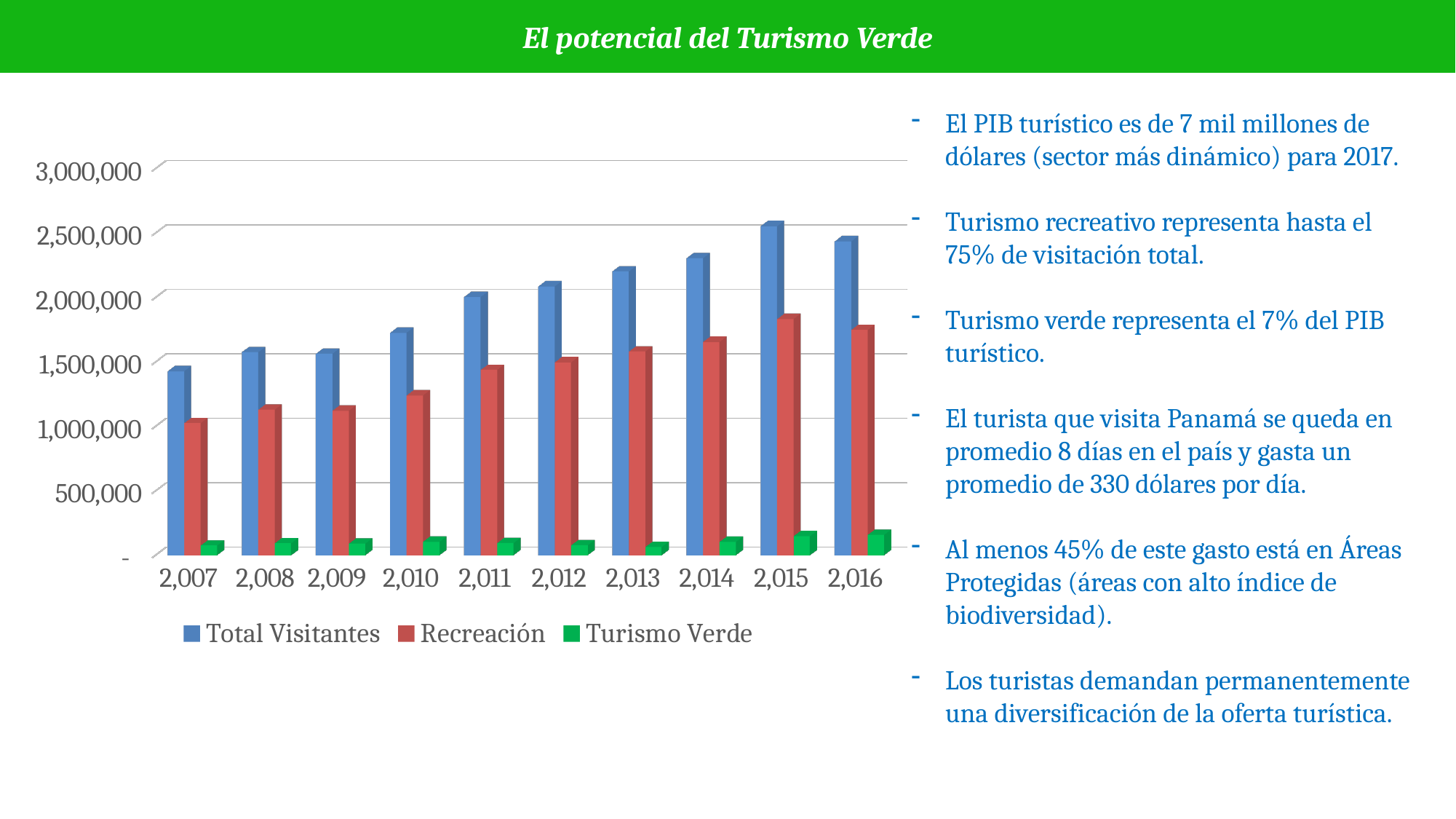
Is the value for Total Visitantes in 2,013 greater or less than 2,000,000? greater Does the Total Visitantes series generally rise or fall from 2,007 to 2,015? Rise Which series is shown in green in the chart? Turismo Verde Is the value for Total Visitantes in 2,007 greater or less than 1,000,000? greater How many series does the chart legend list? 3 How many years are shown on the x axis of the chart? 10 Is the value for Recreación in 2,015 greater or less than 1,500,000? greater In which year is the Total Visitantes bar the lowest? 2,007 What kind of chart is shown on the slide? Bar chart In which year is the Total Visitantes bar the highest? 2,015 Which is larger: Total Visitantes in 2,014 or Total Visitantes in 2,016? Total Visitantes in 2,016